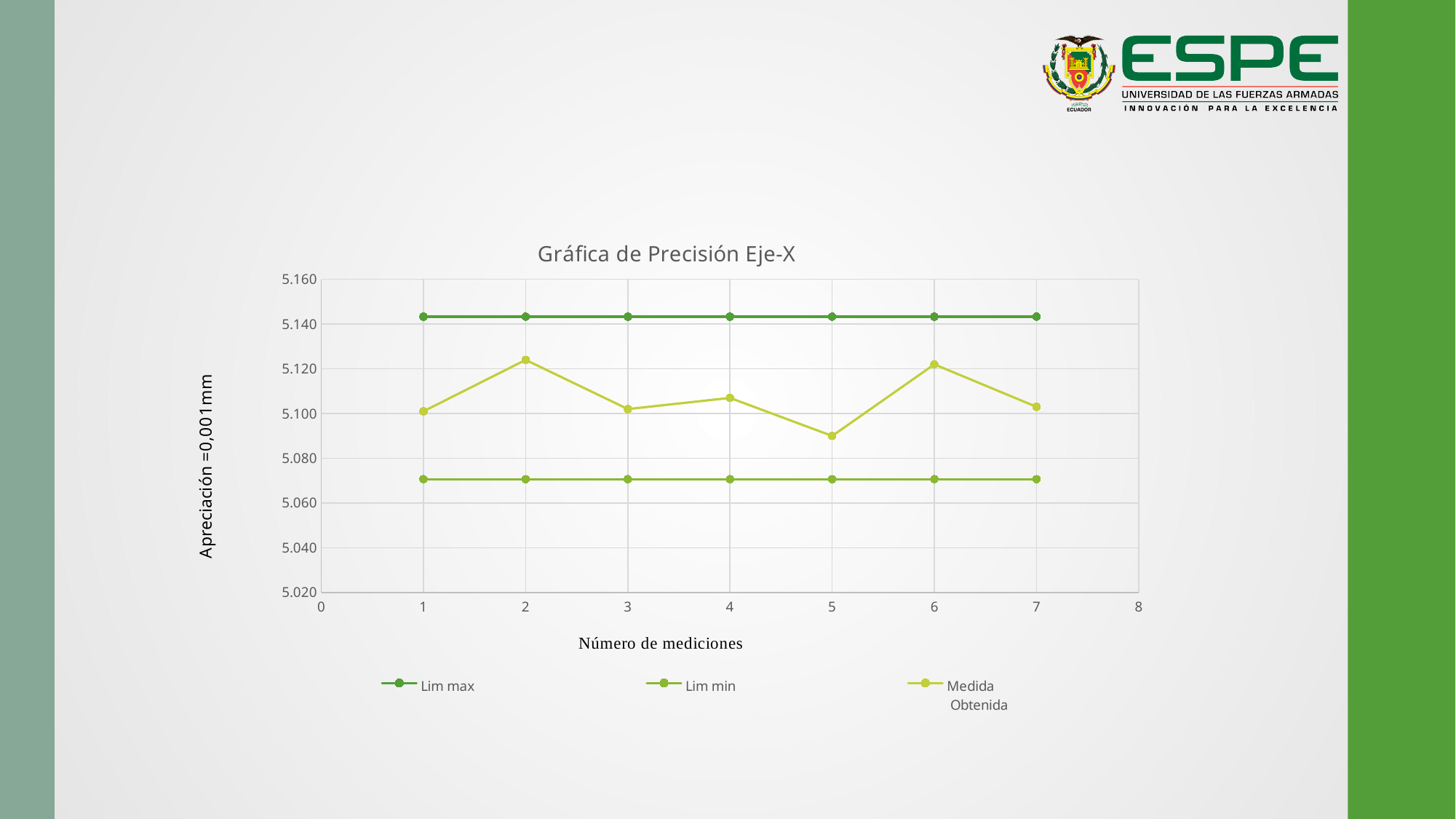
What type of chart is shown on the slide? line chart Is the Lim min value greater or less than 5.080? less Does the Medida Obtenida series rise or fall from measurement 4 to measurement 5? fall How many measurement points are plotted for the Medida Obtenida series? 7 What is the title of the chart? Gráfica de Precisión Eje-X Is the Medida Obtenida value at measurement 5 greater or less than 5.100? less Is the Medida Obtenida value at measurement 2 greater or less than 5.100? greater What is the label of the x axis? Número de mediciones At which measurement number is the Medida Obtenida value lowest? 5 Which is larger for Medida Obtenida: the value at measurement 2 or at measurement 5? measurement 2 How many series does the legend list? 3